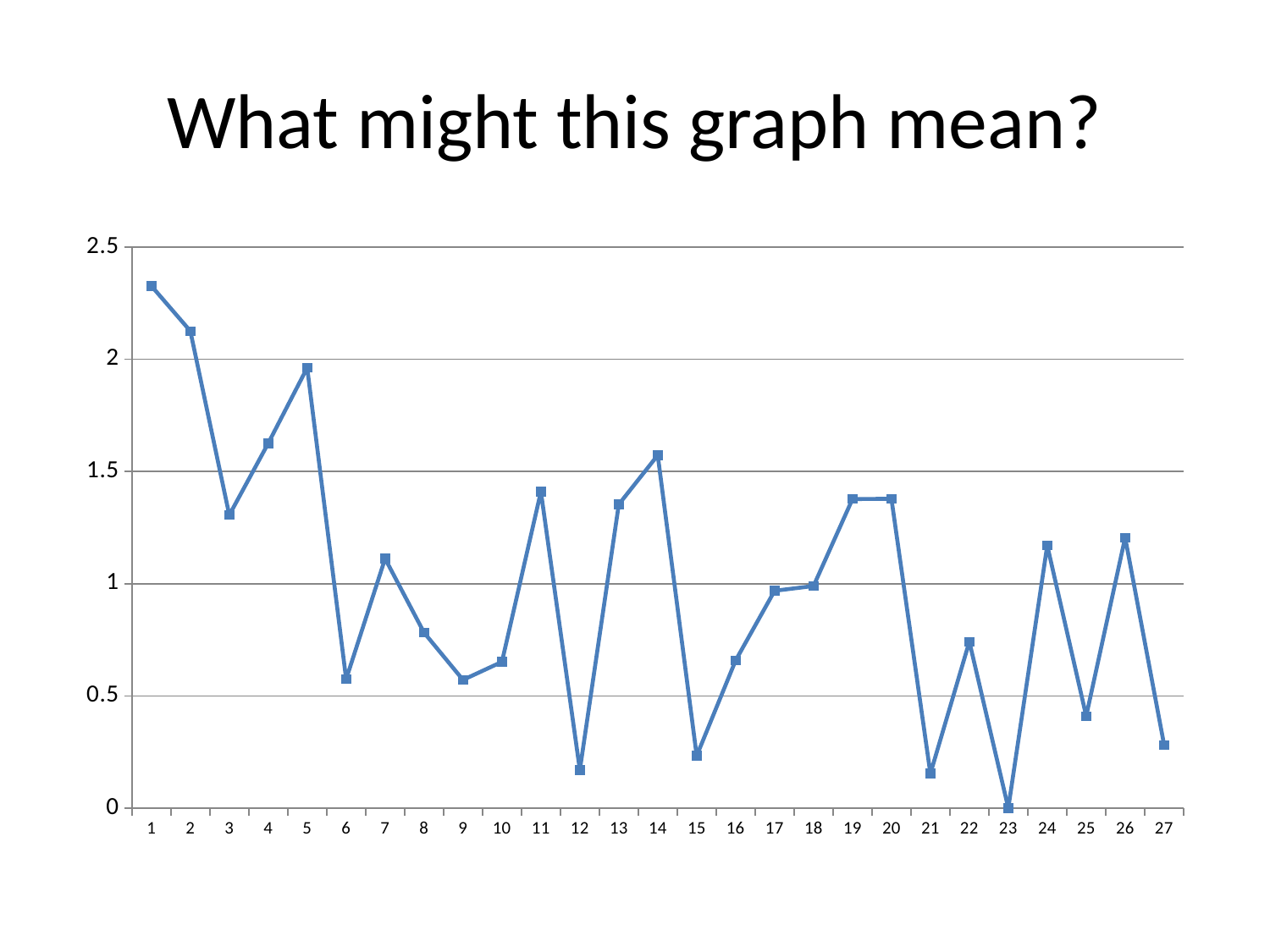
Is the value at category 12 greater or less than 0.5? less What kind of chart is shown on the slide? line chart Which has the larger value, category 2 or category 3? 2 How many points are plotted along the x axis? 27 Which x-axis category has the lowest value? 23 Is the value at category 1 greater or less than 2? greater Which x-axis category has the highest value? 1 Is the value at category 14 greater or less than 1.5? greater Do the values generally rise or fall from category 1 to category 27? fall What is the value at x-axis category 23? 0 What is the title of the slide? What might this graph mean?